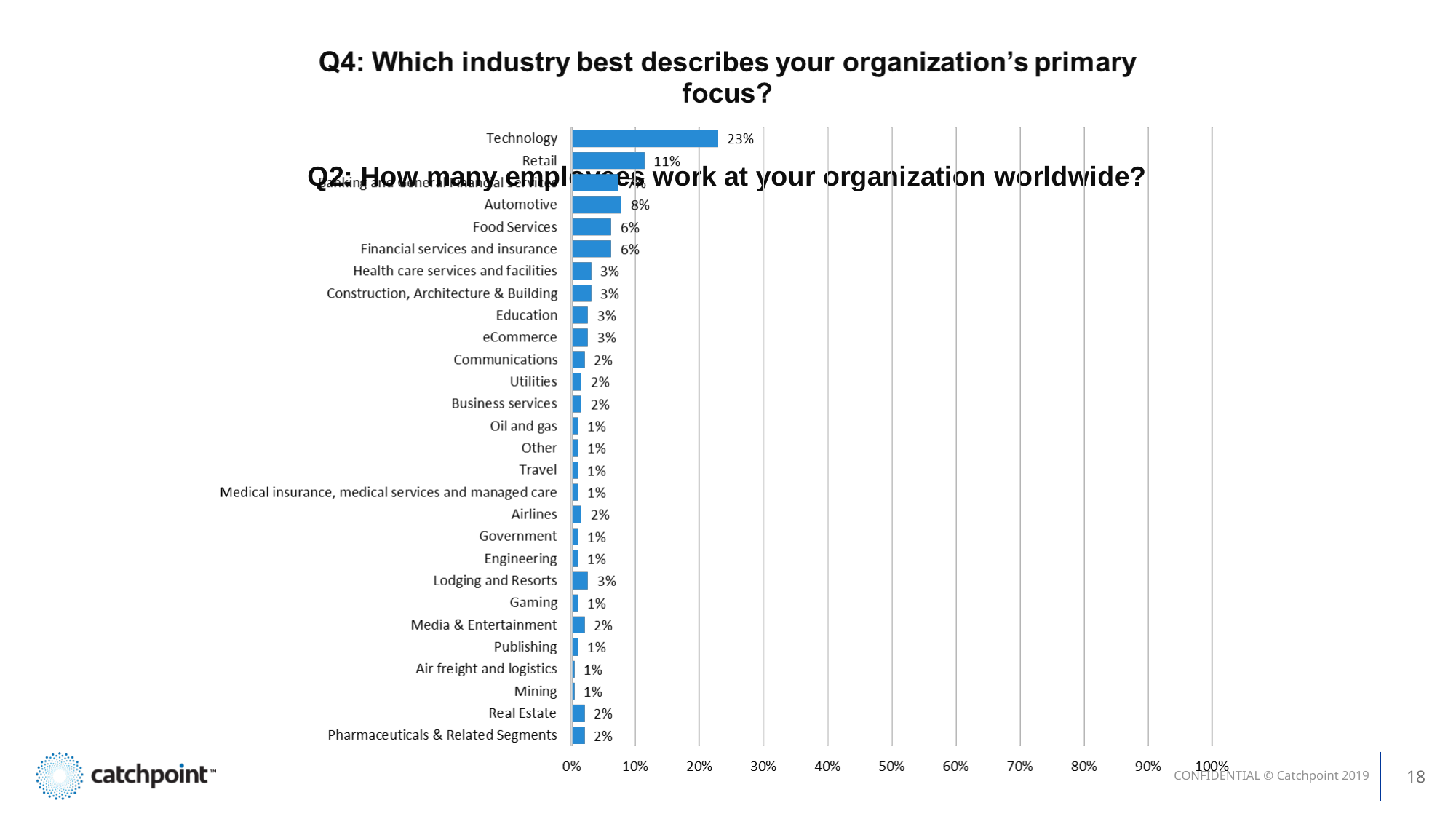
How many industry categories are listed in the chart? 28 What percentage of respondents selected Technology as their organization's primary industry? 23% What is the value for Food Services? 6% What percentage is shown for Automotive? 8% What type of chart is shown on the slide? Bar chart Is the value for Technology greater or less than 20%? greater Which has a larger value, Automotive or Food Services? Automotive What is the difference between the Technology and Retail percentages? 12% What percentage is shown for Lodging and Resorts? 3% What is the value shown for Retail? 11% Which industry has the highest percentage in the chart? Technology